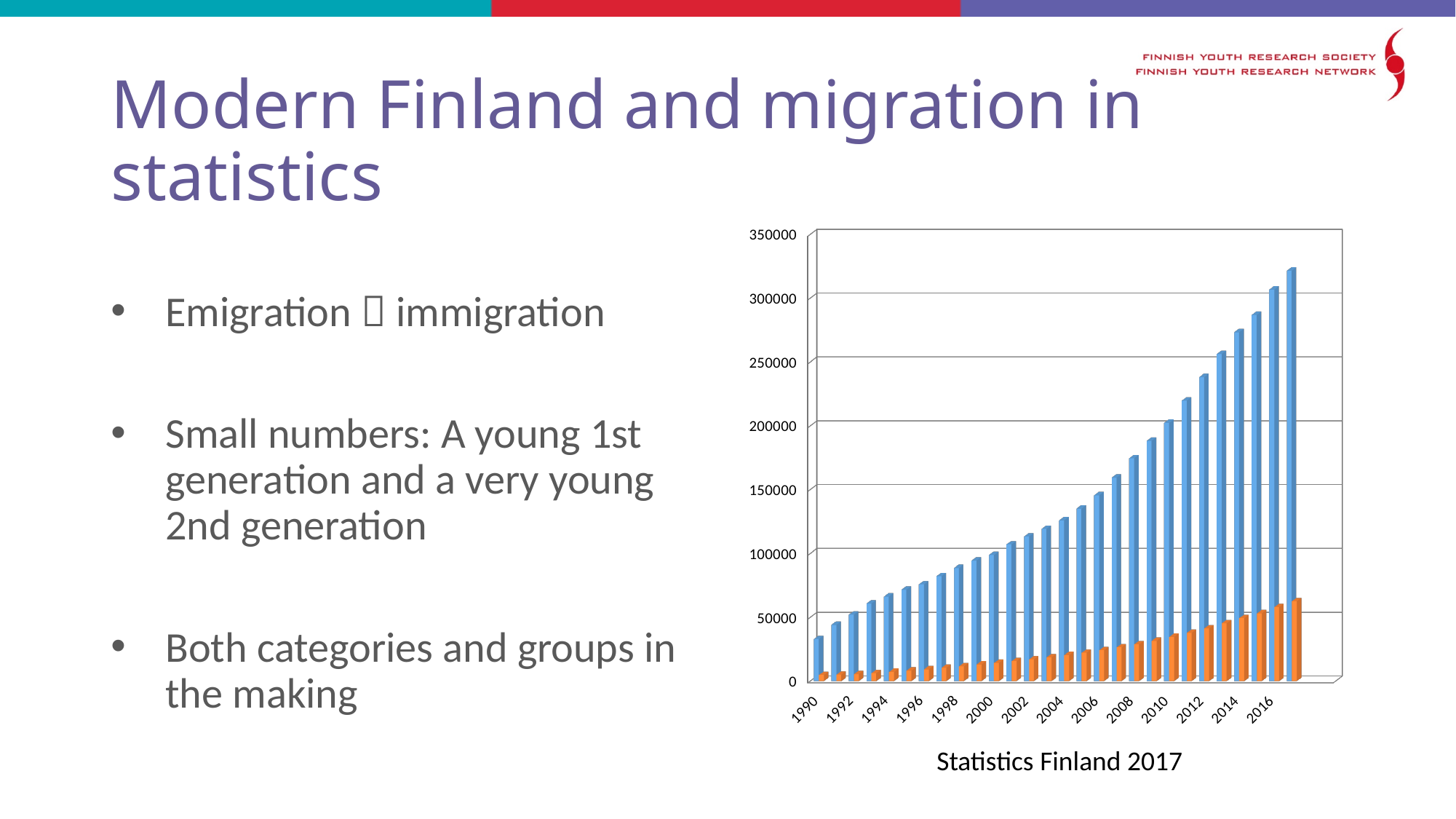
Which labelled year has the lowest blue bar? 1990 What kind of chart is shown on the slide? bar chart How many year labels are shown on the x axis? 14 What source is cited below the chart? Statistics Finland 2017 Is the value of the orange bar for 2010 greater or less than 50000? less Is the value of the blue bar for 1990 greater or less than 50000? less Is the value of the blue bar for 2008 greater or less than 150000? greater Do the blue bars rise or fall from 1990 to the right end of the x axis? rise In 2016, which bar is larger, the blue one or the orange one? the blue one